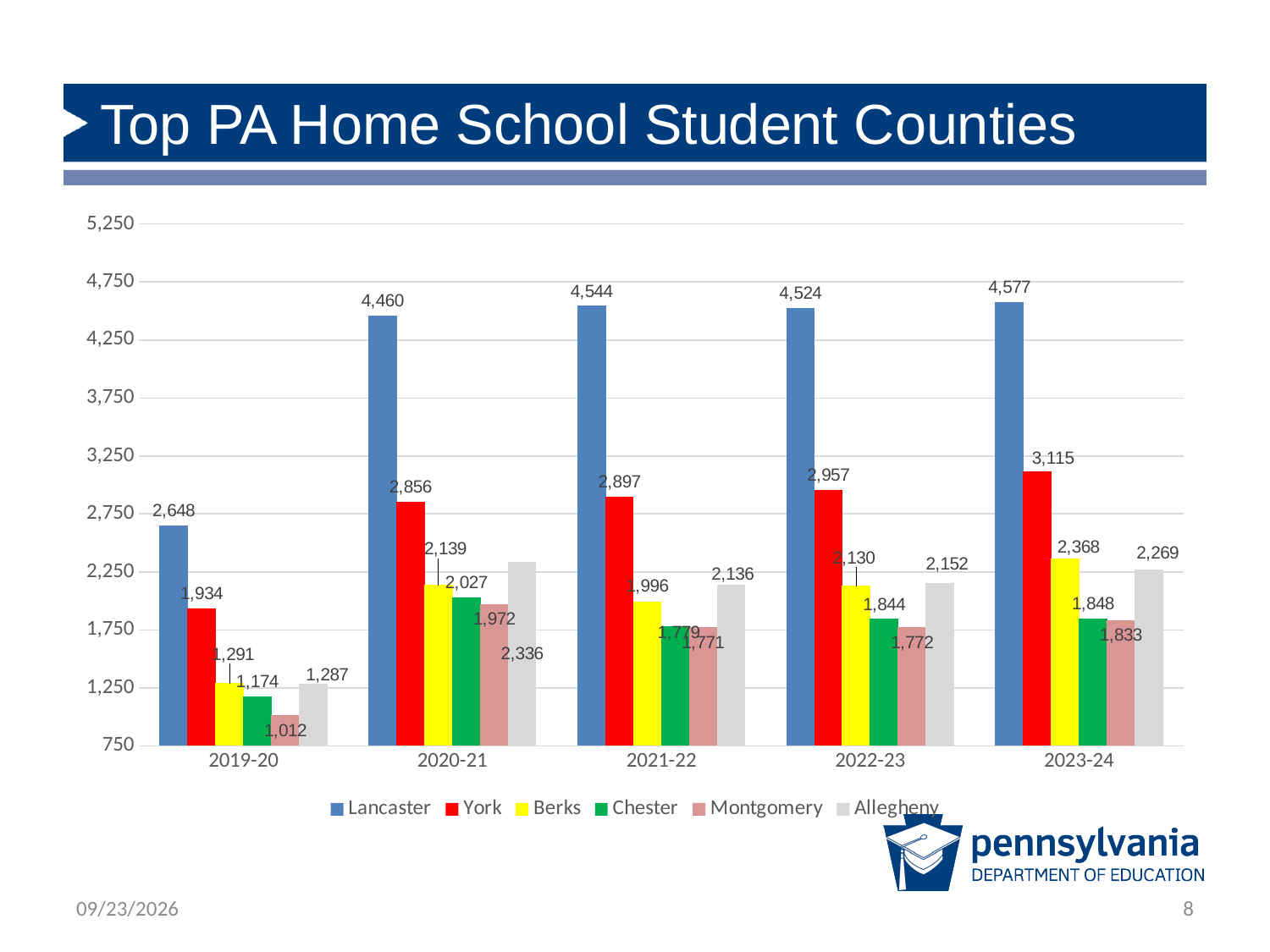
What is the difference between Lancaster's value in 2020-21 and in 2019-20? 1,812 Which is larger in 2023-24, Berks or Allegheny? Berks What is the value for Allegheny in 2022-23? 2,152 What type of chart is shown on the slide? bar chart What is the title of the chart? Top PA Home School Student Counties Which county has the highest value in 2021-22? Lancaster How many school years are shown on the x axis? 5 How many series does the legend list? 6 Does Lancaster's value rise or fall from 2019-20 to 2020-21? rise What is the value for York in 2020-21? 2,856 What is the value for Lancaster in 2023-24? 4,577 Which county has the lowest value in 2019-20? Montgomery